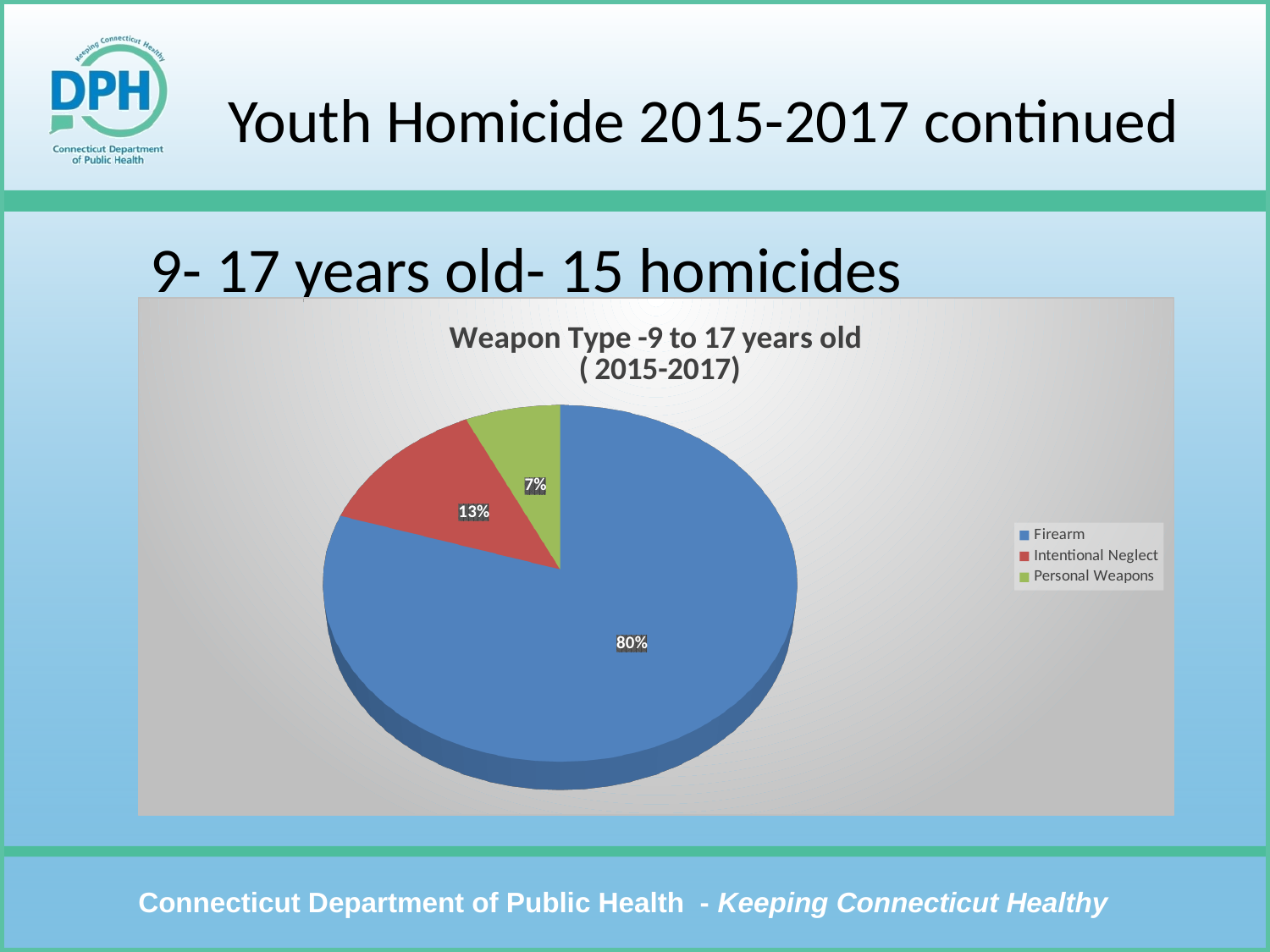
What is the difference in percentage points between the Firearm and Intentional Neglect slices? 67 What is the title of the chart? Weapon Type -9 to 17 years old ( 2015-2017) Which colour represents Intentional Neglect in the chart? Red What percentage of the pie is Personal Weapons? 7% What percentage of the pie is Firearm? 80% What percentage of the pie is Intentional Neglect? 13% What type of chart is shown on the slide? Pie chart Which is larger, the Intentional Neglect slice or the Personal Weapons slice? Intentional Neglect Which weapon type has the smallest share of the pie? Personal Weapons What is the combined share of the Intentional Neglect and Personal Weapons slices? 20% How many categories does the pie chart show? 3 Which weapon type has the largest share of the pie? Firearm